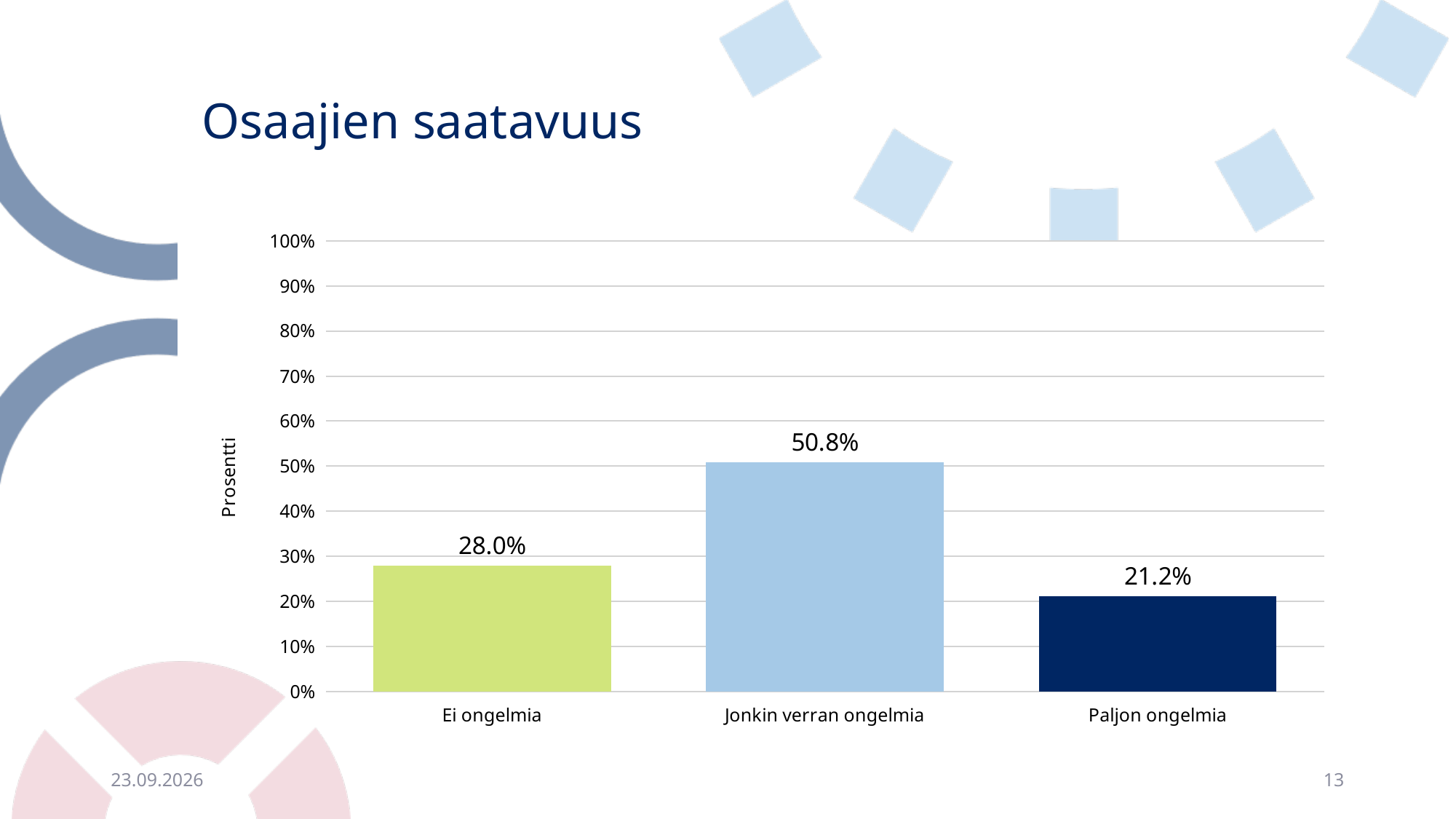
What is the difference between the values for "Ei ongelmia" and "Paljon ongelmia"? 6.8% How many categories are shown on the x axis? 3 Which is larger, the value for "Ei ongelmia" or the value for "Paljon ongelmia"? Ei ongelmia What is the value for "Ei ongelmia"? 28.0% Is the value for "Jonkin verran ongelmia" greater or less than 50%? greater What is the label of the vertical axis? Prosentti Which category has the lowest value? Paljon ongelmia What is the value for "Jonkin verran ongelmia"? 50.8% What is the value for "Paljon ongelmia"? 21.2% What is the difference between the values for "Jonkin verran ongelmia" and "Ei ongelmia"? 22.8% Which category has the highest value? Jonkin verran ongelmia What kind of chart is shown on the slide? bar chart